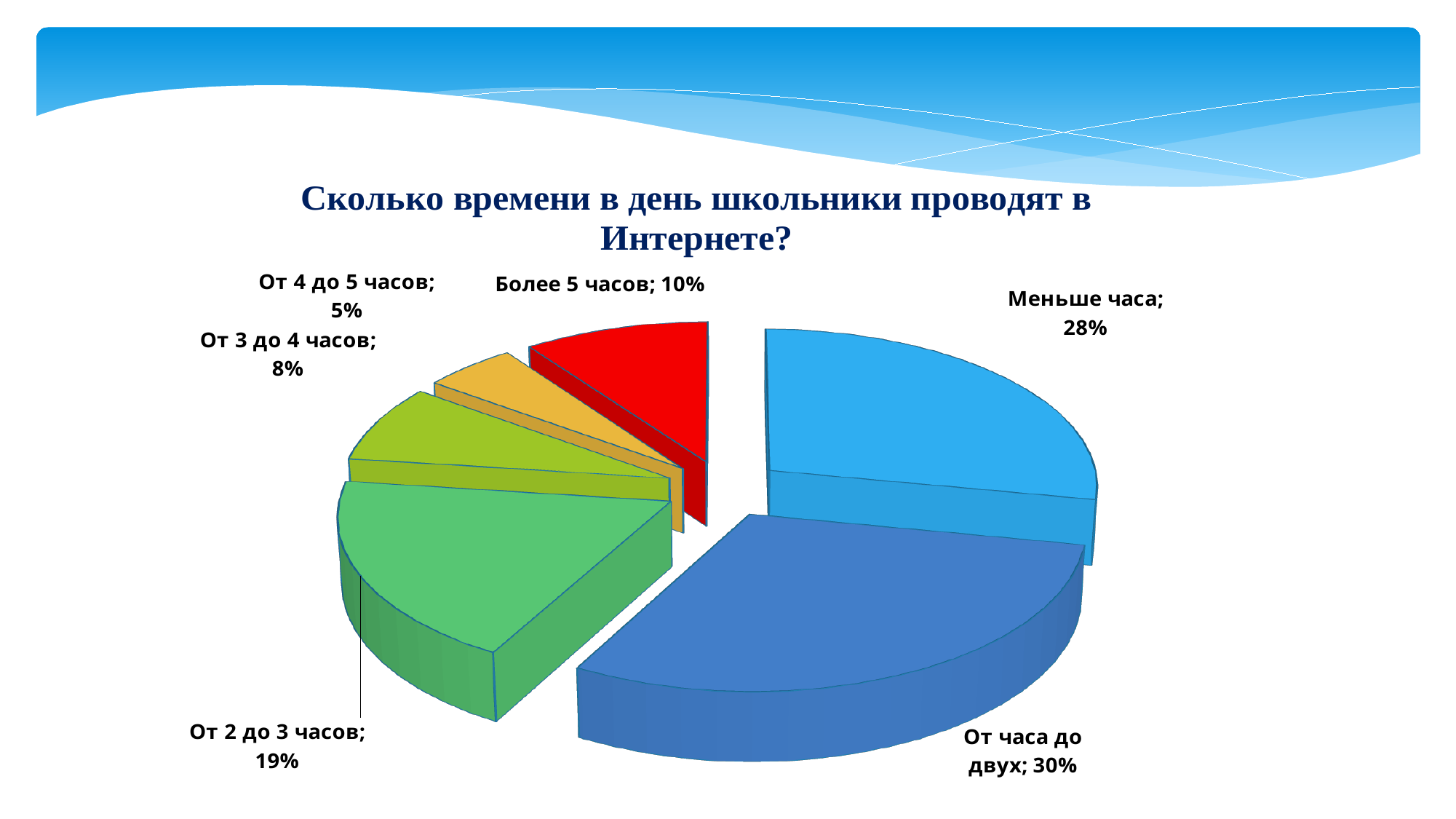
What is the title of the chart? Сколько времени в день школьники проводят в Интернете? Which is larger: the share for "Более 5 часов" or the share for "От 3 до 4 часов"? Более 5 часов What share of the pie is labelled "От 3 до 4 часов"? 8% What share of the pie is labelled "От часа до двух"? 30% What share of the pie is labelled "Более 5 часов"? 10% What is the difference between the shares for "Меньше часа" and "От 2 до 3 часов"? 9% Which category has the largest share of the pie? От часа до двух How many slices does the pie chart have? 6 What kind of chart is shown on the slide? pie chart What share of the pie is labelled "Меньше часа"? 28% What share of the pie is labelled "От 2 до 3 часов"? 19% Which category has the smallest share of the pie? От 4 до 5 часов